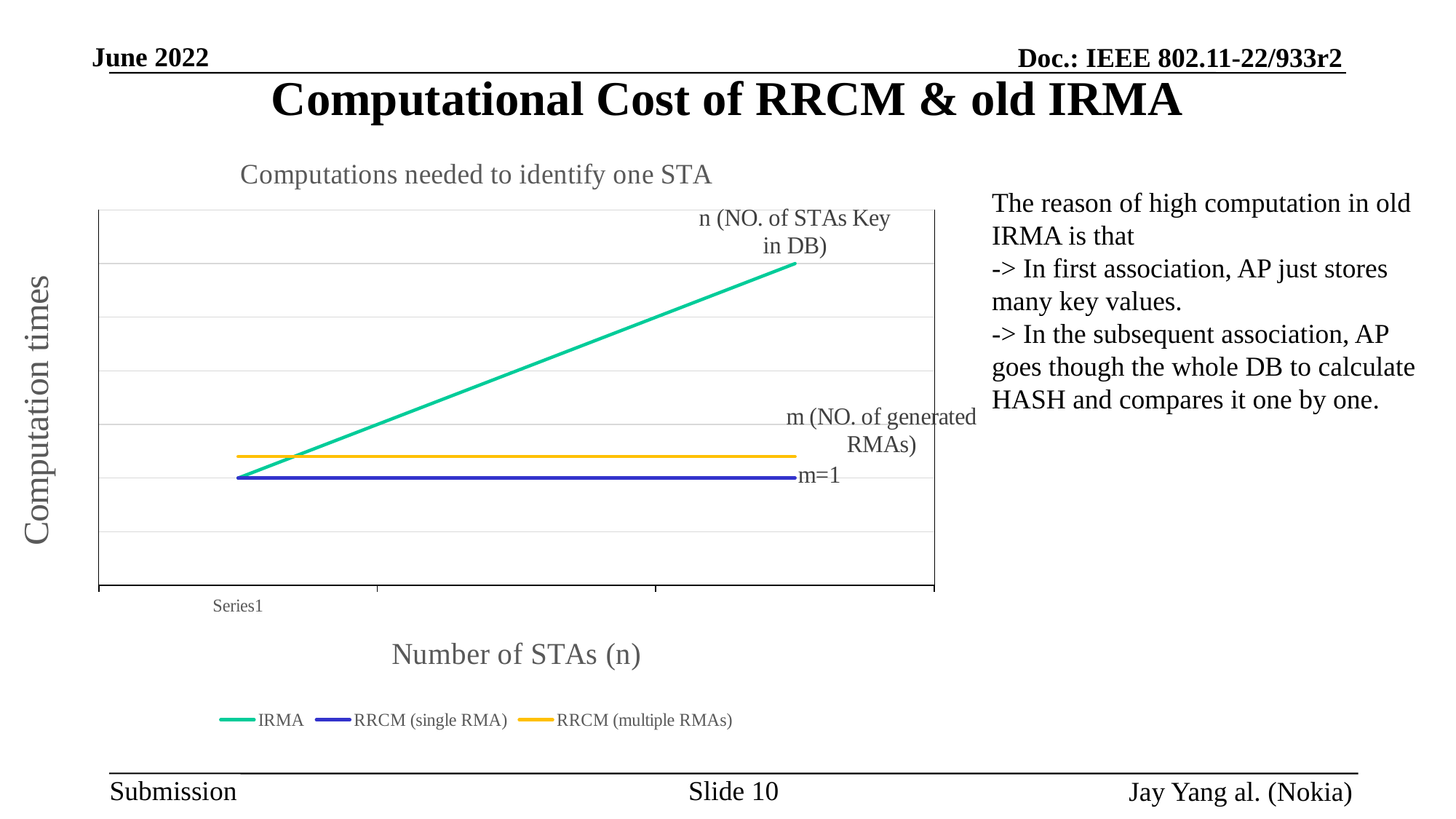
What data label is shown at the end of the RRCM (single RMA) line? m=1 What data label is shown at the end of the IRMA line? n (NO. of STAs Key in DB) What is the title of the chart? Computations needed to identify one STA How many series does the legend list? 3 What kind of chart is shown on the slide? line chart Does the IRMA line rise or fall as the number of STAs increases? rise At the right end of the chart, which is higher: IRMA or RRCM (multiple RMAs)? IRMA What is the label of the x axis? Number of STAs (n) Which series has the lowest computation times across the chart? RRCM (single RMA) Does the RRCM (single RMA) line rise, fall, or stay flat as the number of STAs increases? stay flat Which is higher: RRCM (multiple RMAs) or RRCM (single RMA)? RRCM (multiple RMAs) Which series reaches the highest computation times at the right end of the chart? IRMA